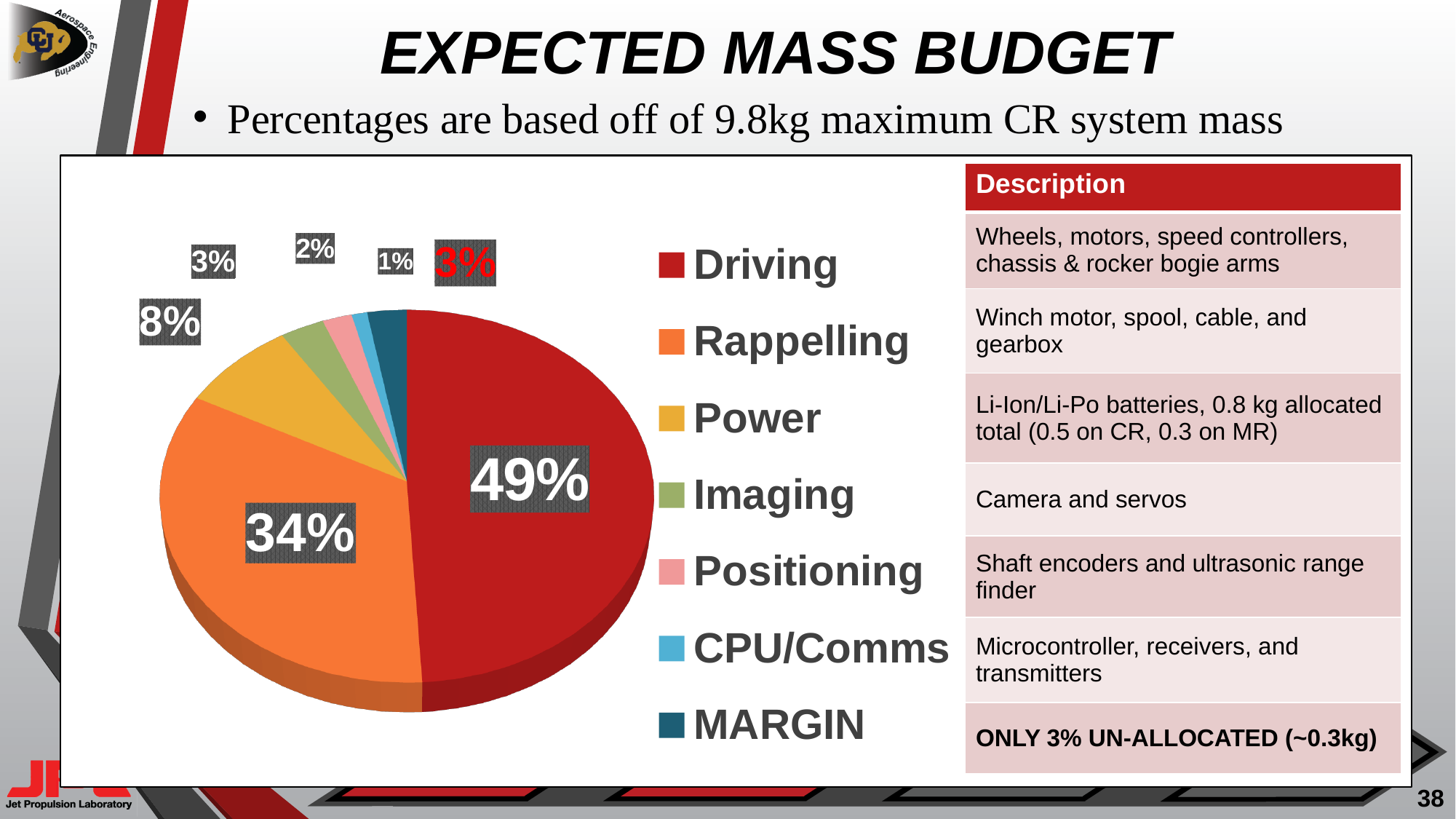
What colour is the Rappelling slice in the pie chart? orange Which category has the smallest share of the pie? CPU/Comms What kind of chart is shown on the slide? pie chart What percentage of the mass budget is allocated to MARGIN? 3% How many categories does the legend list? 7 What percentage of the mass budget is allocated to Rappelling? 34% Which category has the largest share of the pie? Driving What percentage of the mass budget is allocated to Driving? 49% What is the difference in percentage points between Driving and Rappelling? 15 What percentage of the mass budget is allocated to Power? 8% Which has a larger share, Power or Imaging? Power What percentage of the mass budget is allocated to CPU/Comms? 1%